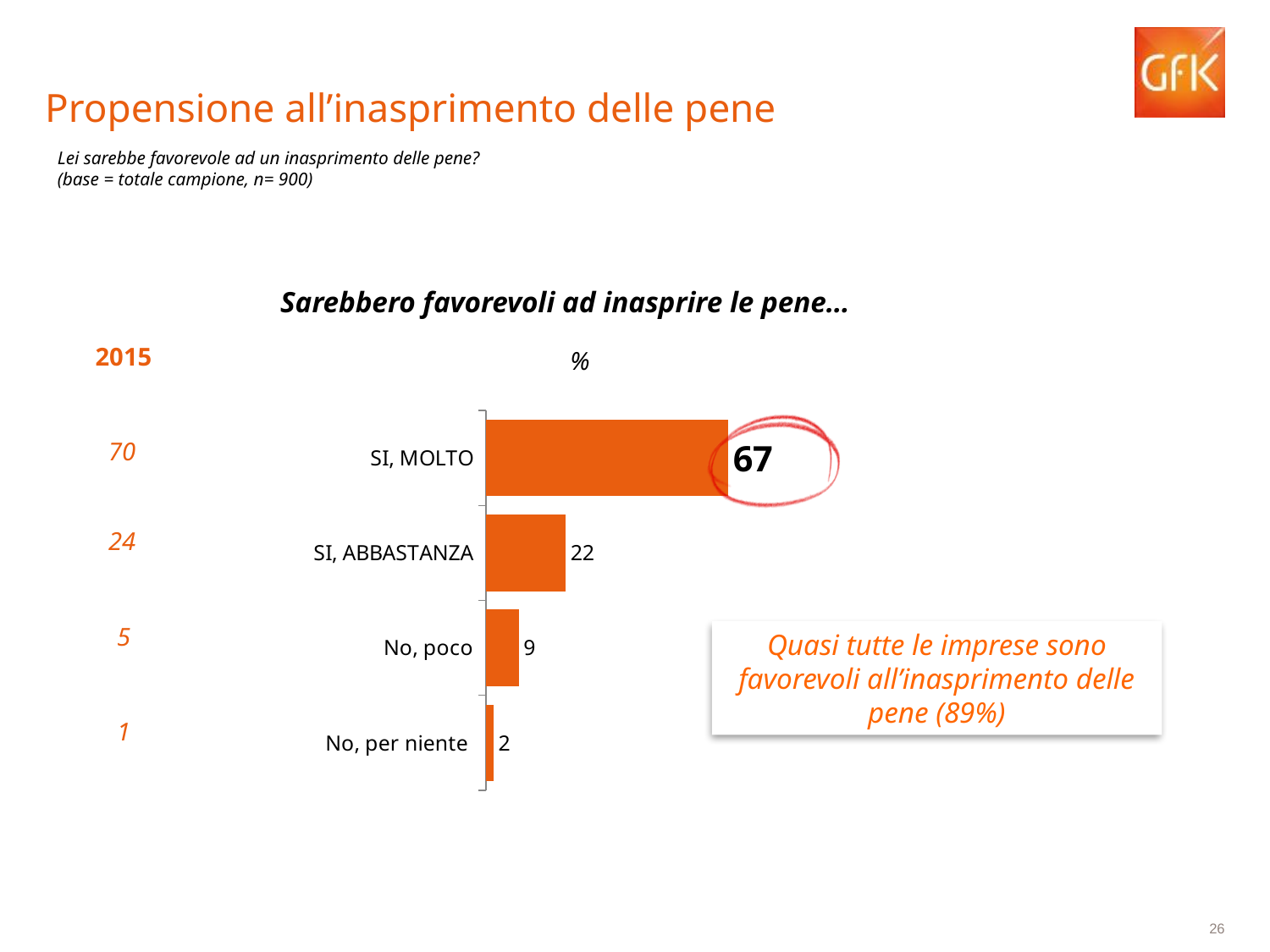
What is the value for SI, ABBASTANZA? 22 Which category has the highest value? SI, MOLTO What kind of chart is shown on the slide? Bar chart What is the difference between the values for No, poco and No, per niente? 7 What is the difference between the values for SI, MOLTO and SI, ABBASTANZA? 45 What is the value for SI, MOLTO? 67 What is the title of the chart? Sarebbero favorevoli ad inasprire le pene… How many categories are shown in the chart? 4 What is the value for No, per niente? 2 Which category has the lowest value? No, per niente Which is larger, the value for SI, ABBASTANZA or the value for No, poco? SI, ABBASTANZA What is the value for No, poco? 9